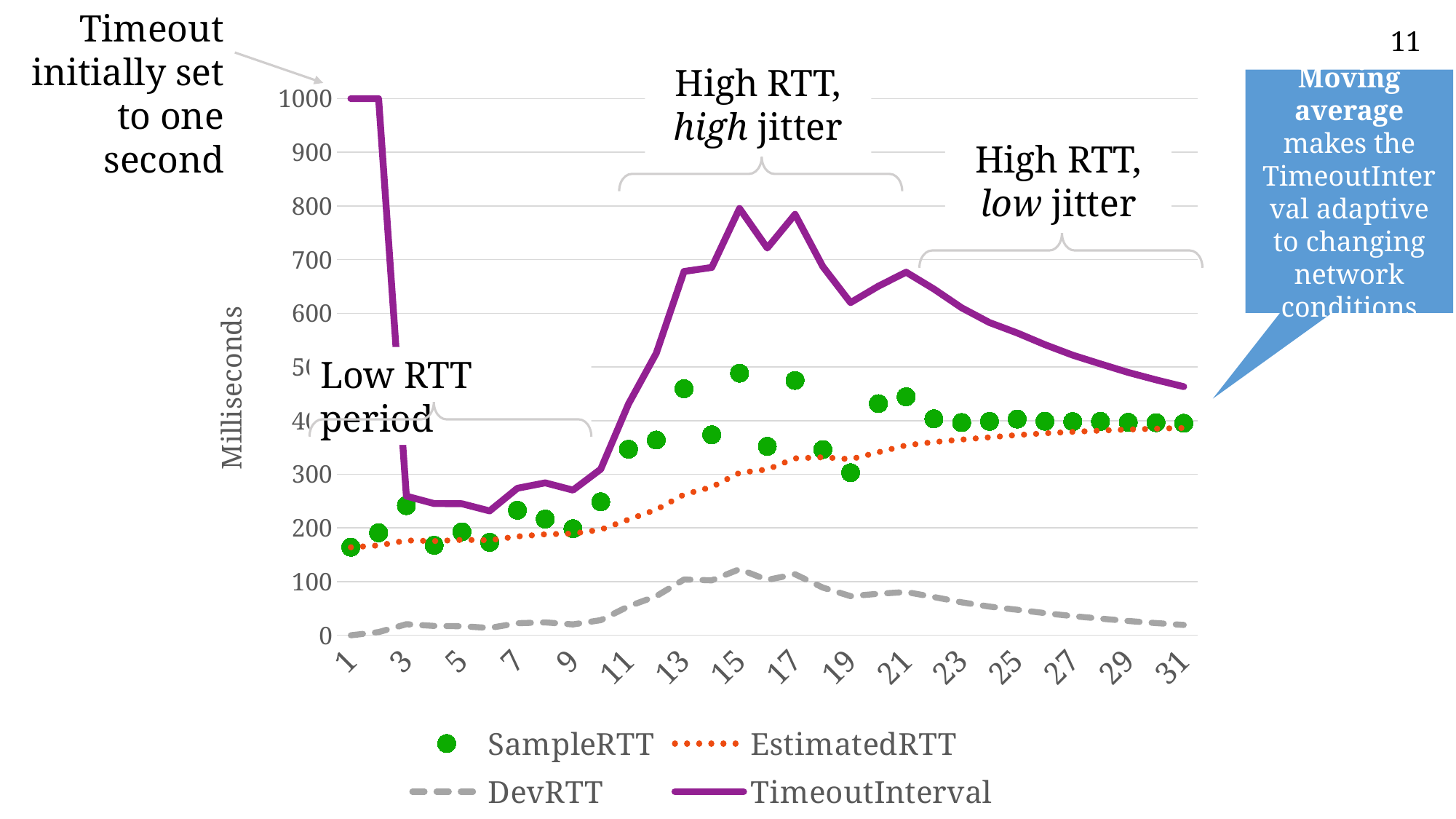
Which series has the lowest values across the whole x axis? DevRTT Does TimeoutInterval rise or fall from x = 21 to x = 31? fall Is the value of SampleRTT at x = 1 greater or less than 200? less Which series are listed in the legend? SampleRTT, EstimatedRTT, DevRTT, TimeoutInterval How many series does the legend list? 4 What is the label on the y axis? Milliseconds Which series has the highest value at x = 1? TimeoutInterval Is the value of TimeoutInterval at x = 15 greater or less than 700? greater What is the value of TimeoutInterval at x = 1? 1000 At x = 15, which is larger: TimeoutInterval or SampleRTT? TimeoutInterval What kind of chart is shown on the slide? line chart Is the value of DevRTT at x = 15 greater or less than 200? less